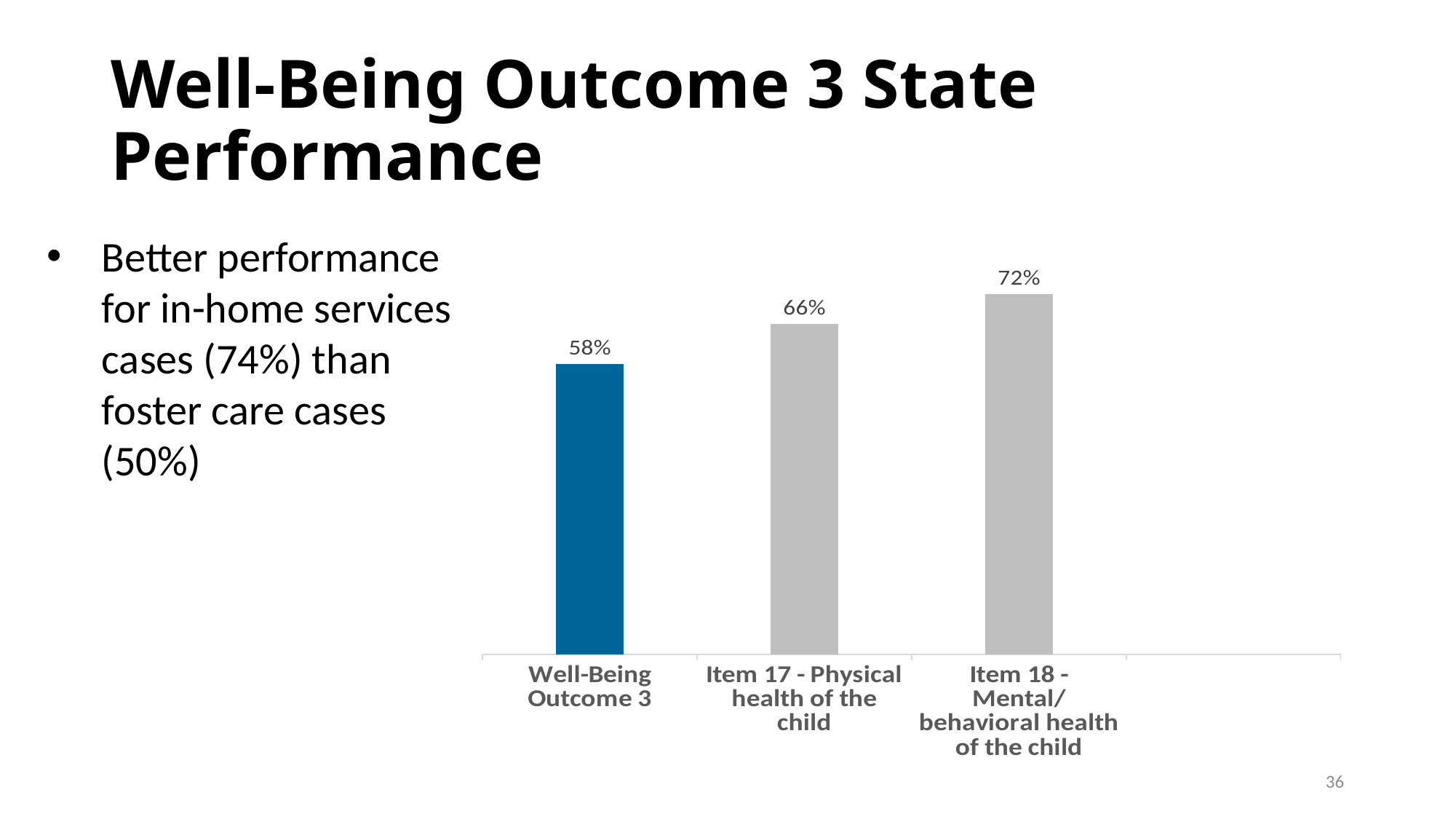
Which bar is coloured blue rather than grey? Well-Being Outcome 3 Which is larger, the value for Item 17 - Physical health of the child or the value for Item 18 - Mental/behavioral health of the child? Item 18 - Mental/behavioral health of the child What is the value for Well-Being Outcome 3? 58% Do the values rise or fall from left to right across the categories? Rise Which category has the highest value? Item 18 - Mental/behavioral health of the child Which category has the lowest value? Well-Being Outcome 3 What is the value for Item 18 - Mental/behavioral health of the child? 72% What is the difference between the values for Item 17 - Physical health of the child and Well-Being Outcome 3? 8% How many categories are shown in the chart? 3 What is the value for Item 17 - Physical health of the child? 66% What kind of chart is shown on the slide? Bar chart What is the difference between the values for Item 18 - Mental/behavioral health of the child and Well-Being Outcome 3? 14%